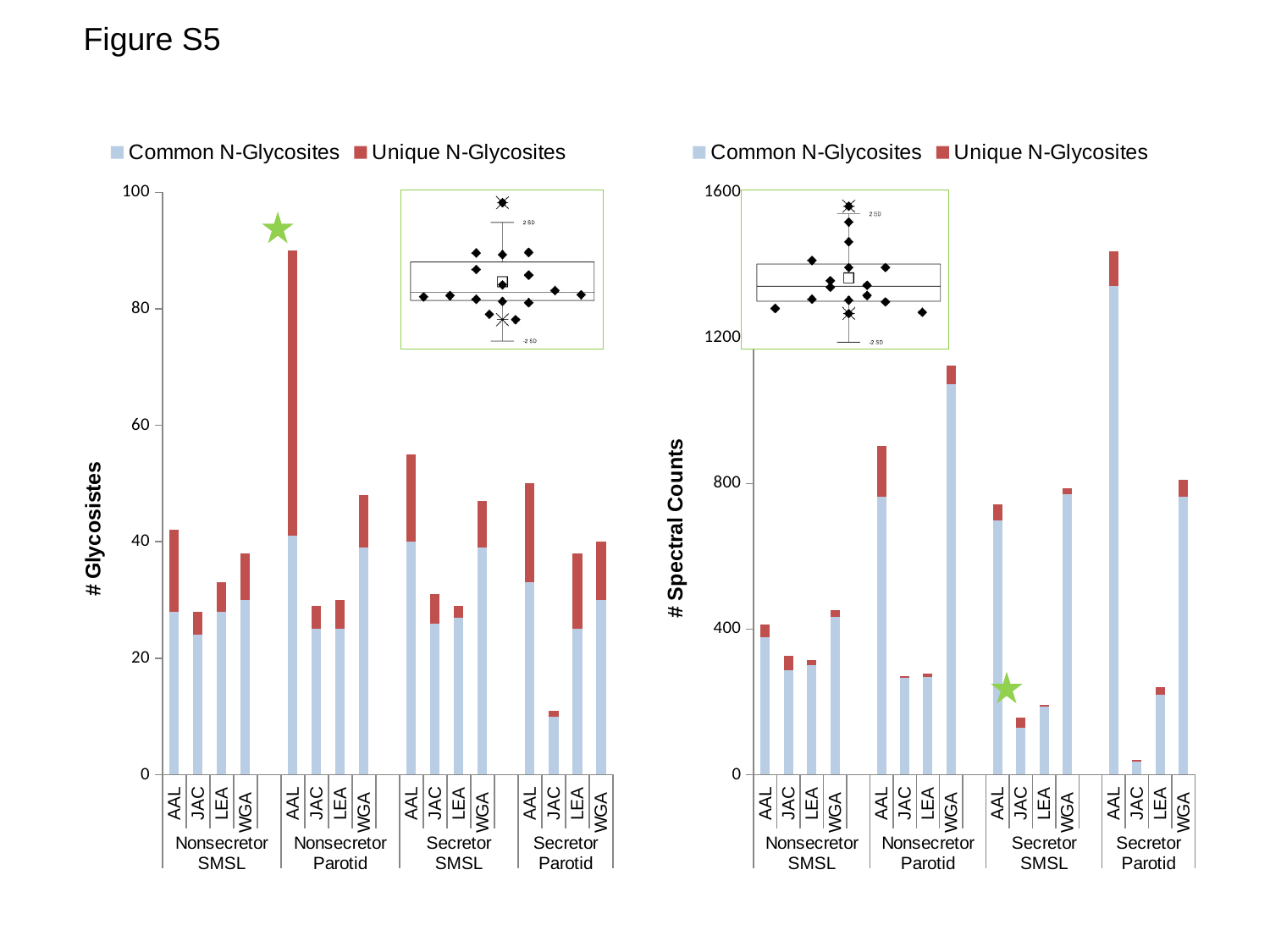
How many series does the legend of the right chart (# Spectral Counts) list? 2 In the right chart (# Spectral Counts), which bar has the lowest total? JAC in Secretor Parotid In the left chart (# Glycosistes), which bar has the lowest total? JAC in Secretor Parotid In the right chart (# Spectral Counts), is the total for WGA in Nonsecretor Parotid greater or less than 800? greater In the left chart (# Glycosistes), which has the larger total in Secretor SMSL: AAL or JAC? AAL In the right chart (# Spectral Counts), which bar has the highest total? AAL in Secretor Parotid In the right chart (# Spectral Counts), which has the larger total: AAL in Nonsecretor Parotid or AAL in Nonsecretor SMSL? AAL in Nonsecretor Parotid In the left chart (# Glycosistes), which bar has the highest total? AAL in Nonsecretor Parotid In the left chart (# Glycosistes), is the total for AAL in Nonsecretor Parotid greater or less than 80? greater What are the two series named in the legend of the left chart (# Glycosistes)? Common N-Glycosites and Unique N-Glycosites How many bars are plotted in the right chart (# Spectral Counts)? 16 What kind of chart is the left chart (# Glycosistes)? Stacked bar chart